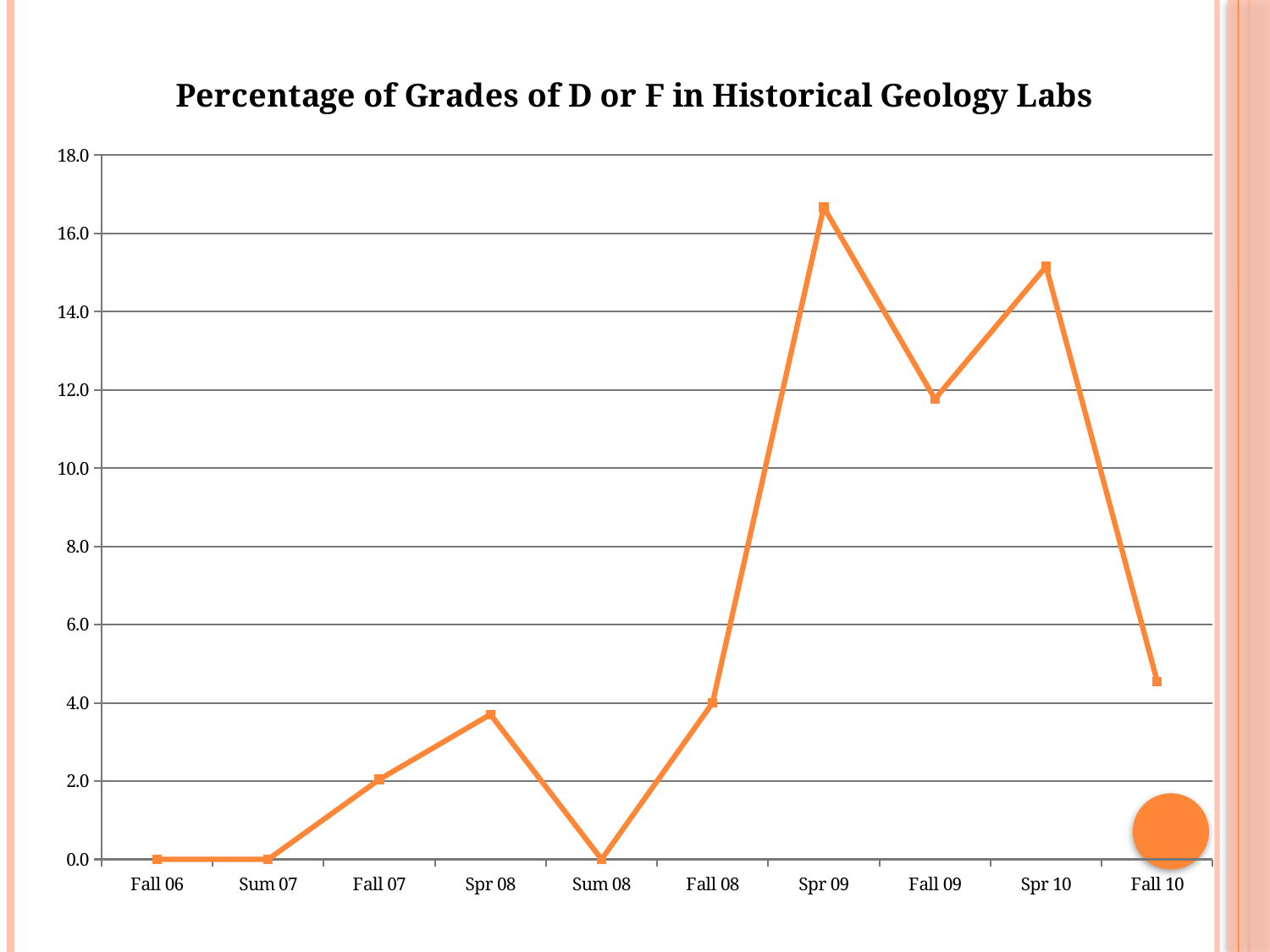
Is the value for Spr 09 greater or less than 16.0? greater Is the value for Spr 10 greater or less than 14.0? greater Which term has the highest percentage of D or F grades? Spr 09 Is the value for Spr 08 greater or less than 4.0? less Which is larger, the value for Spr 09 or the value for Spr 10? Spr 09 What is the value for Fall 06? 0.0 How many terms are plotted along the x axis? 10 What is the title of the chart? Percentage of Grades of D or F in Historical Geology Labs What kind of chart is shown on the slide? line chart What is the value for Sum 08? 0.0 Does the value rise or fall from Spr 10 to Fall 10? fall